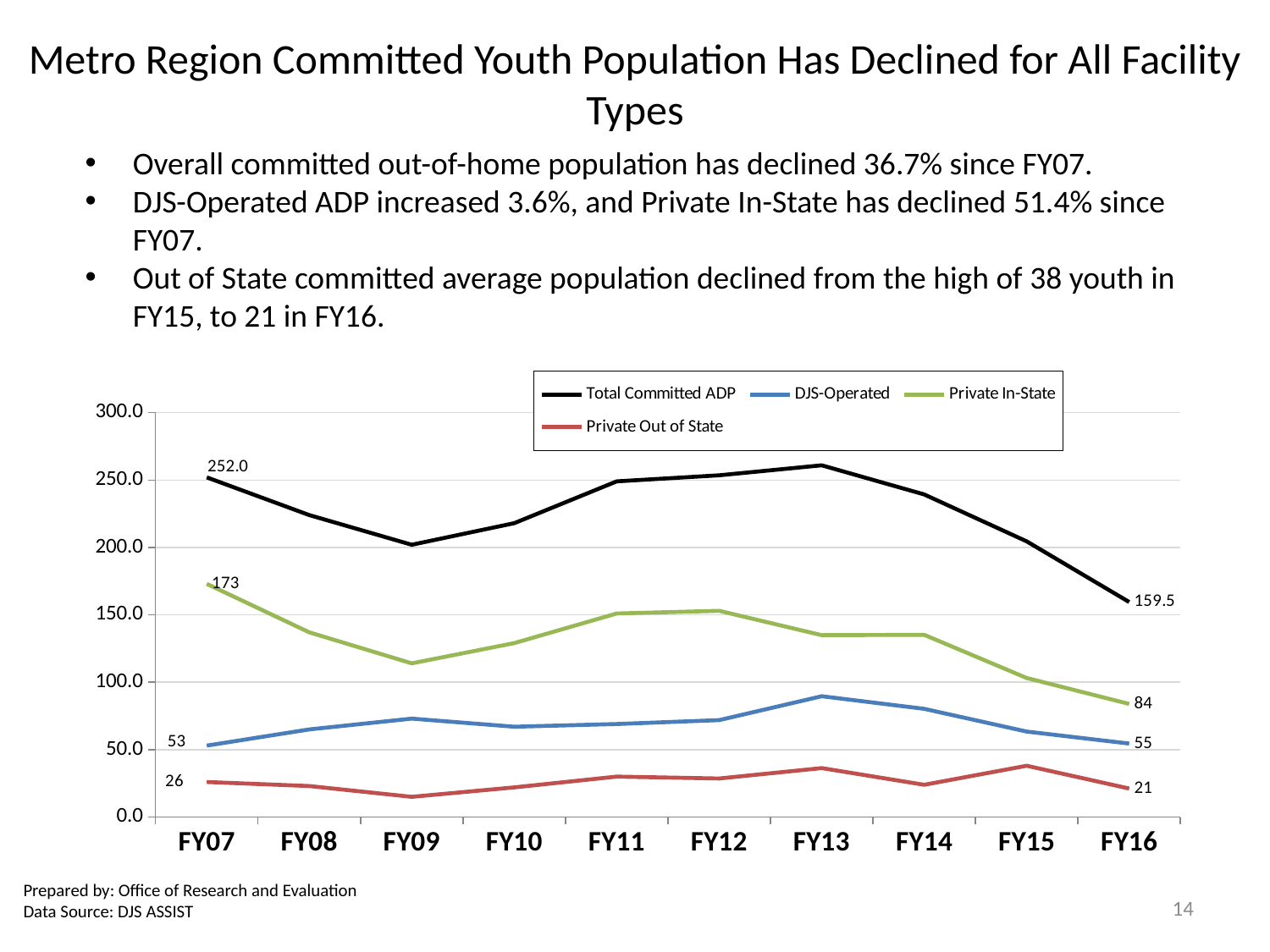
How many fiscal years are shown on the x axis? 10 What kind of chart is shown on the slide? line chart What is the Total Committed ADP value for FY16? 159.5 In FY16, which is larger: Private In-State or DJS-Operated? Private In-State How many series does the legend list? 4 What is the Private In-State value for FY07? 173 What is the difference between the Private In-State values for FY07 and FY16? 89 By how much did Total Committed ADP decline from FY07 to FY16? 92.5 What is the Private Out of State value for FY07? 26 What is the DJS-Operated value for FY16? 55 What is the Total Committed ADP value for FY07? 252.0 Is the Private In-State value for FY09 greater or less than 150? less